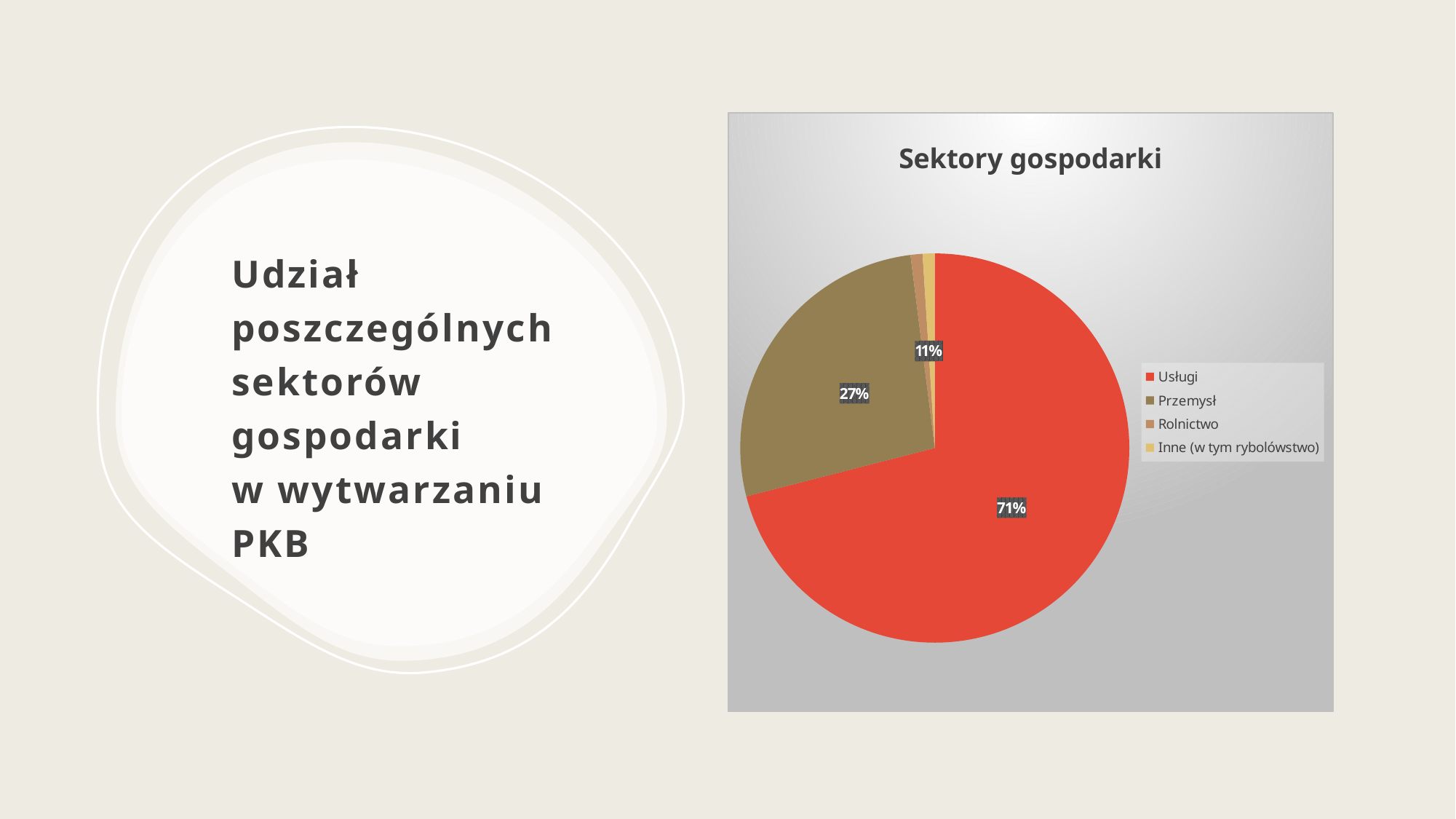
Which is larger, the share of Usługi or the share of Przemysł? Usługi Which sector has the second-largest slice in the pie chart? Przemysł What percentage share does Przemysł have in the pie chart? 27% How many entries does the legend list? 4 What percentage share does Usługi have in the pie chart? 71% What is the title of the chart? Sektory gospodarki What kind of chart is shown on the slide? Pie chart How many sectors are shown in the pie chart? 4 By how many percentage points does the Usługi share exceed the Przemysł share? 44 percentage points Which sector has the largest slice in the pie chart? Usługi What colour is the Usługi slice in the pie chart? Red